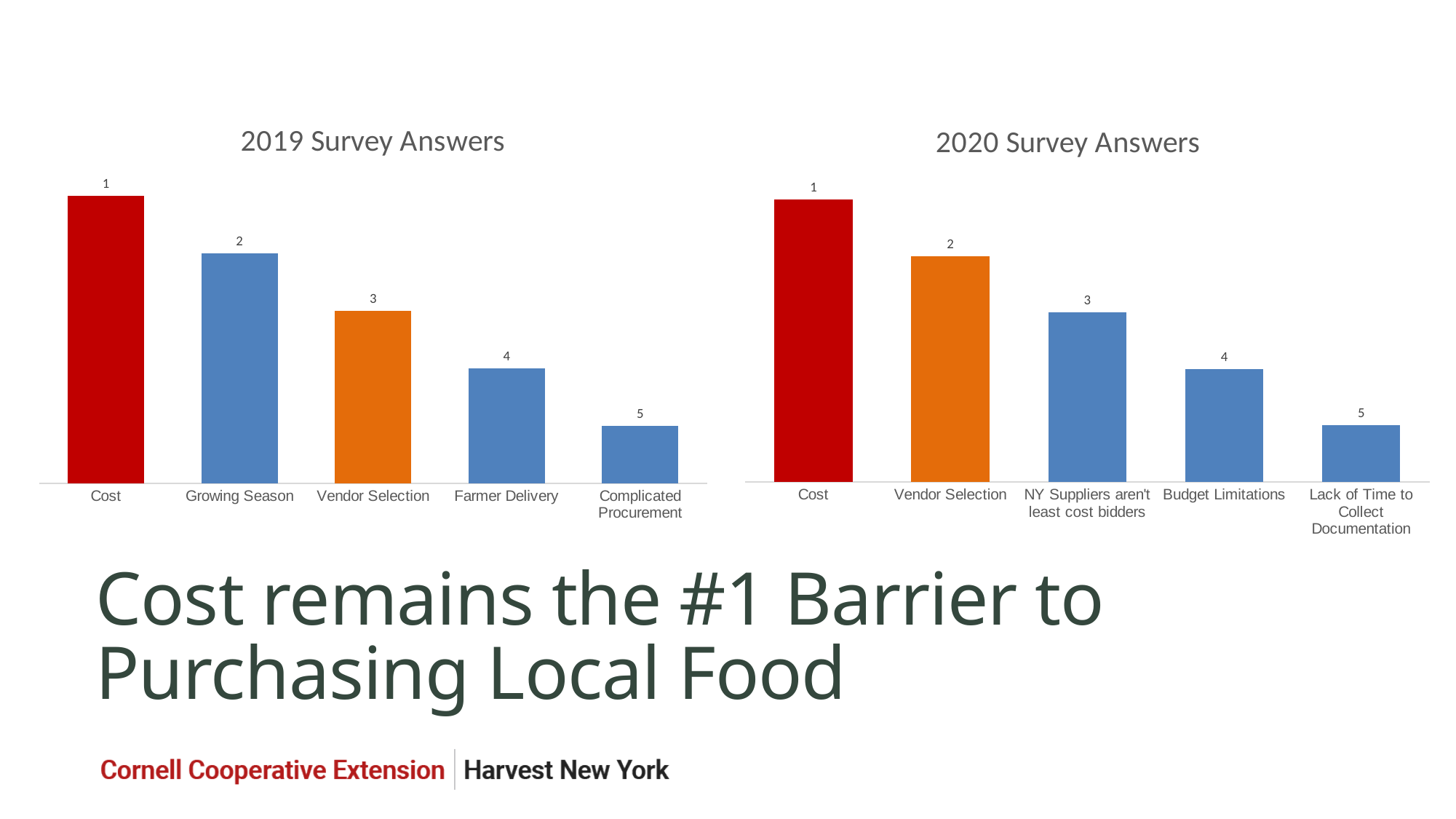
In the 2020 Survey Answers chart, what data label is shown on the Budget Limitations bar? 4 In the 2019 Survey Answers chart, what data label is shown on the Cost bar? 1 In the 2019 Survey Answers chart, what data label is shown on the Vendor Selection bar? 3 How many categories are shown in the 2020 Survey Answers chart? 5 In the 2020 Survey Answers chart, do the bar heights rise or fall from left to right? Fall In the 2019 Survey Answers chart, which category has the shortest bar? Complicated Procurement In the 2019 Survey Answers chart, which category has the tallest bar? Cost What type of chart is the 2019 Survey Answers chart? Bar chart In the 2020 Survey Answers chart, what data label is shown on the Lack of Time to Collect Documentation bar? 5 In the 2020 Survey Answers chart, which category has the shortest bar? Lack of Time to Collect Documentation In the 2020 Survey Answers chart, what colour is the Cost bar? Red In the 2019 Survey Answers chart, which bar is taller: Growing Season or Farmer Delivery? Growing Season